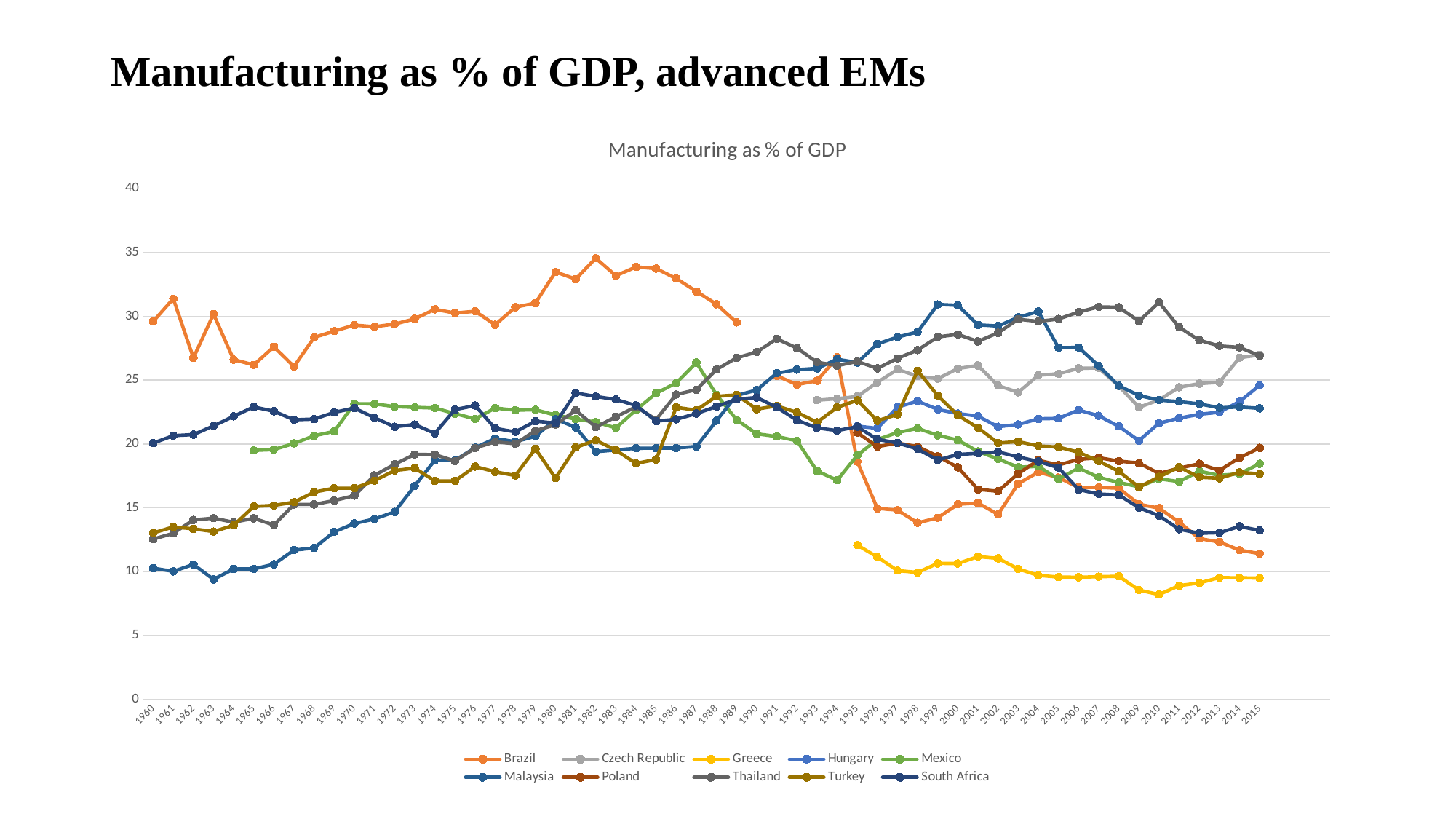
Is the value for Greece in 2010 greater or less than 10? less How many series does the legend list? 10 In 2015, which is larger, the value for Thailand or the value for Greece? Thailand Is the value for Hungary in 2015 greater or less than 20? greater Is the value for Malaysia in 1960 greater or less than 15? less Which series has the highest value in 1960? Brazil What kind of chart is shown on the slide? Line chart What is the title printed above the chart area? Manufacturing as % of GDP How many years are shown on the x axis? 56 Does the value for Greece rise or fall overall from 1995 to 2015? fall Which series has the lowest value in 2015? Greece